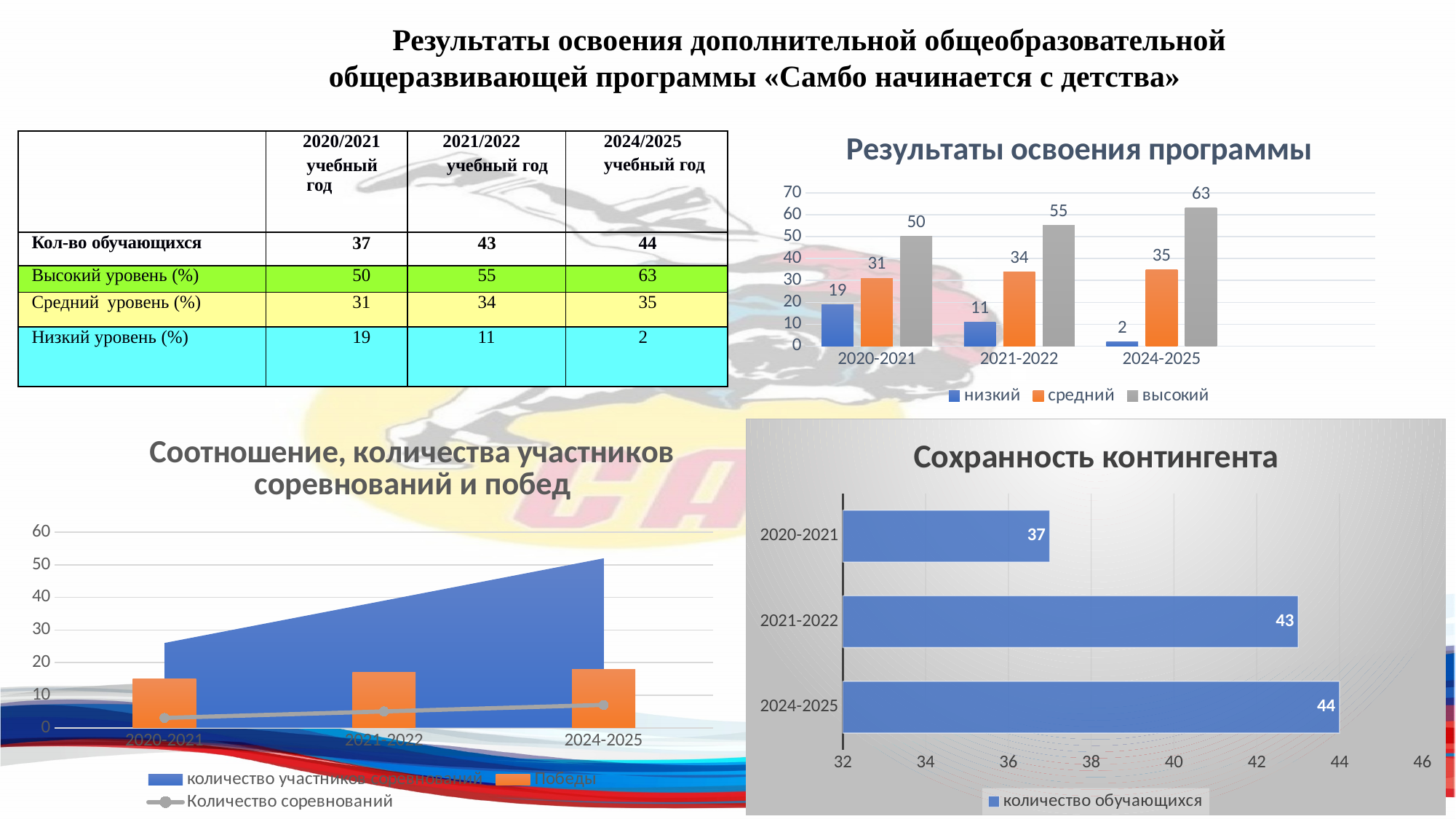
In the chart 'Результаты освоения программы', how many series does the legend list? 3 In the chart 'Соотношение, количества участников соревнований и побед', is the value for 'количество участников соревнований' in 2024-2025 greater or less than 40? greater In the chart 'Сохранность контингента', which year has the highest value? 2024-2025 What kind of chart is 'Сохранность контингента'? bar chart In the chart 'Результаты освоения программы', what is the difference between the 'высокий' values for 2024-2025 and 2020-2021? 13 In the chart 'Результаты освоения программы', which year has the lowest value for 'низкий'? 2024-2025 In the chart 'Результаты освоения программы', what is the value for 'низкий' in 2021-2022? 11 In the chart 'Результаты освоения программы', what is the value for 'высокий' in 2024-2025? 63 In the chart 'Результаты освоения программы', do the 'средний' values rise or fall from 2020-2021 to 2024-2025? rise In the chart 'Соотношение, количества участников соревнований и побед', how many categories are shown on the x axis? 3 In the chart 'Сохранность контингента', what is the difference between the values for 2024-2025 and 2020-2021? 7 In the chart 'Сохранность контингента', what is the value for 2021-2022? 43